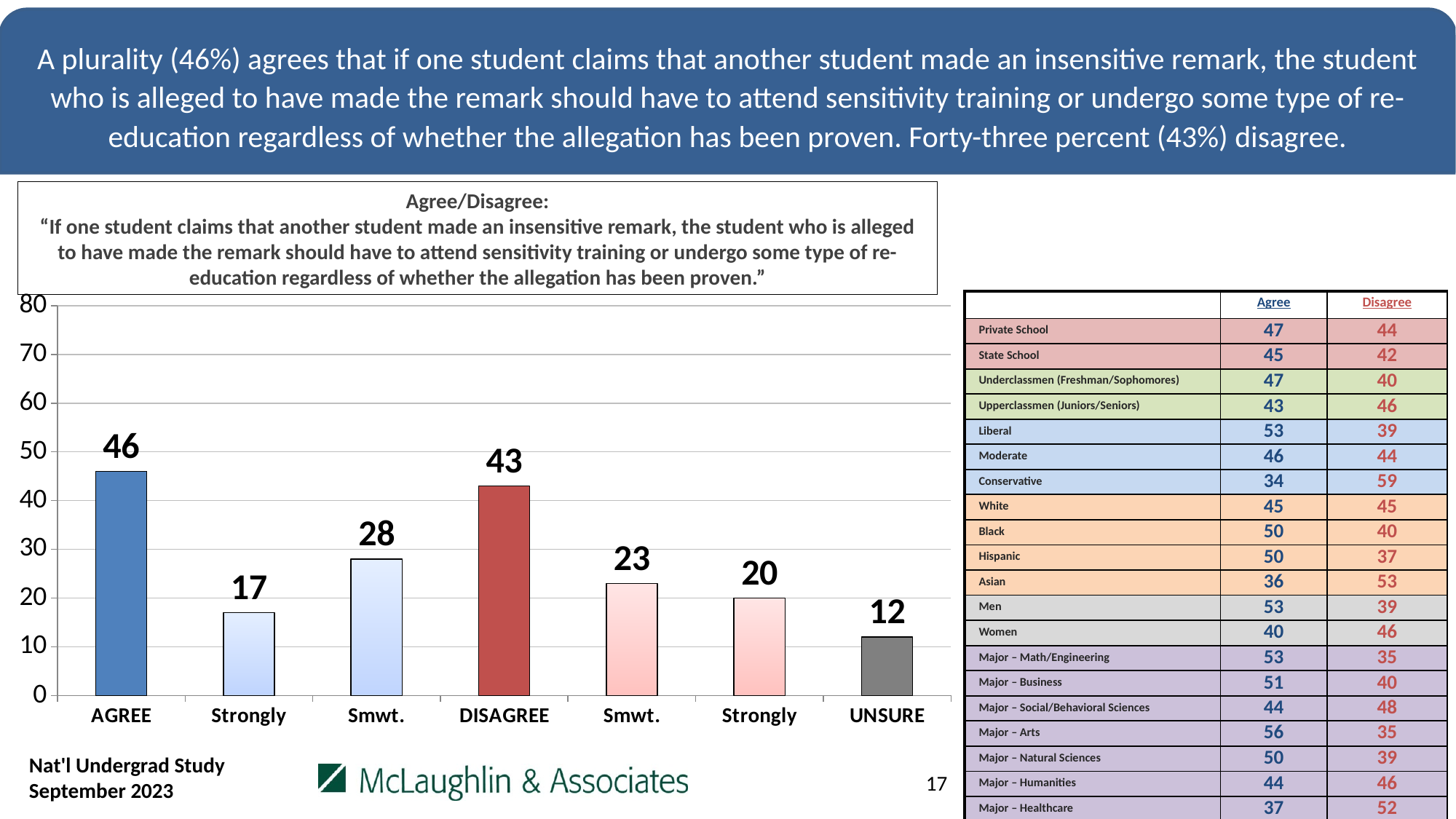
What colour is the DISAGREE bar? Red What is the value of the DISAGREE bar? 43 What is the value of the Smwt. bar immediately to the right of DISAGREE? 23 What is the value of the Strongly bar immediately to the right of AGREE? 17 How many bars are shown in the chart? 7 Which category has the lowest bar? UNSURE Which category has the highest bar? AGREE Which is larger, the Smwt. bar next to AGREE or the Smwt. bar next to DISAGREE? The Smwt. bar next to AGREE (28) What is the value of the UNSURE bar? 12 What type of chart is shown on the slide? Bar chart What is the difference between the AGREE and DISAGREE values? 3 What is the value of the AGREE bar? 46